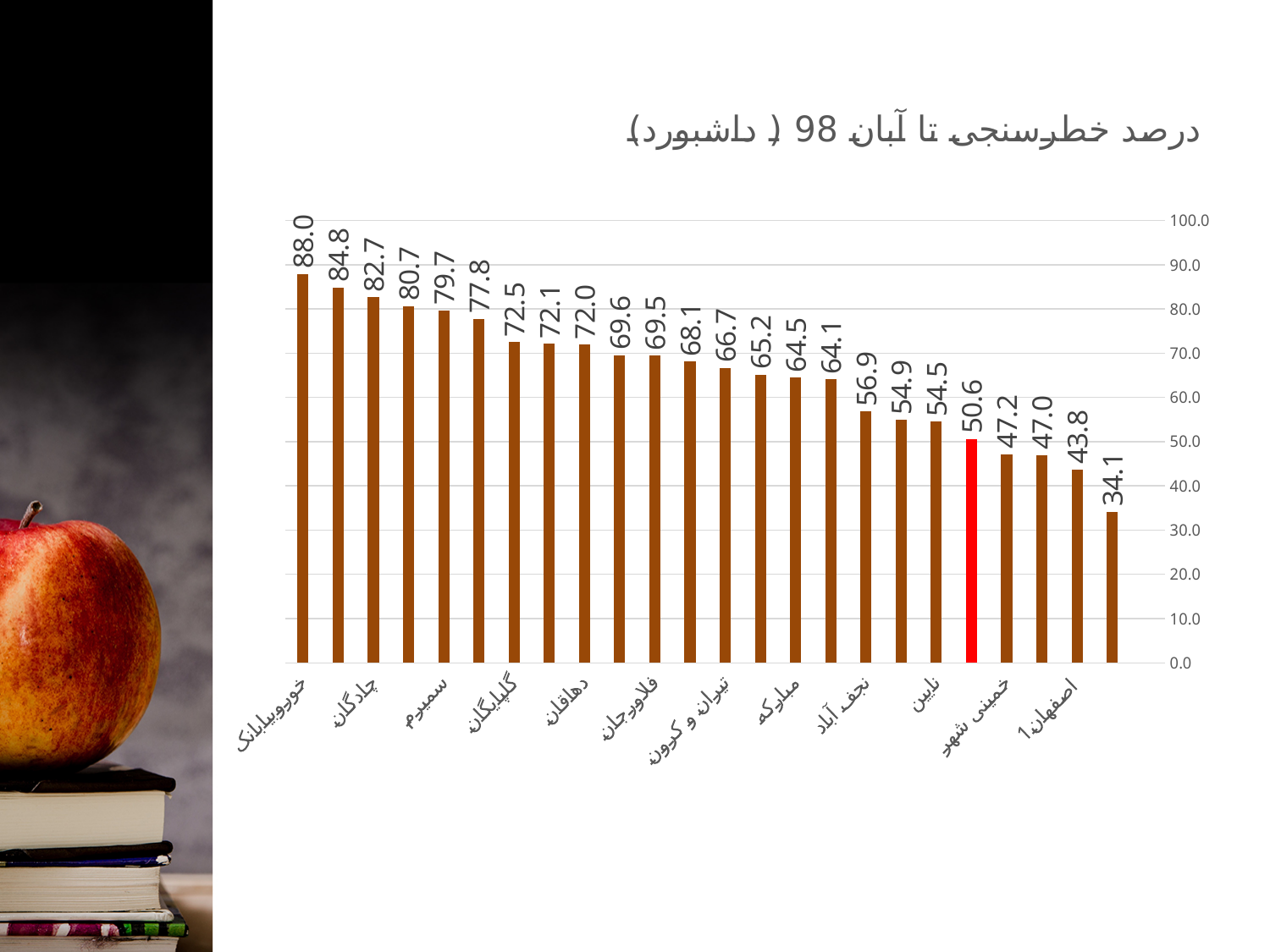
What is the value of the lowest bar in the chart? 34.1 Do the bar values rise or fall from left to right across the chart? fall What is the value for نجف آباد? 56.9 What is the difference between the highest bar (88.0) and the lowest bar (34.1)? 53.9 How many bars are plotted in the chart? 24 What is the value for خوروبیابانک? 88.0 What is the value for چادگان? 82.7 What is the value for اصفهان1? 43.8 Which has a larger value, چادگان or سمیرم? چادگان What is the value of the highest bar in the chart? 88.0 What is the value of the red bar? 50.6 What type of chart is shown on the slide? bar chart